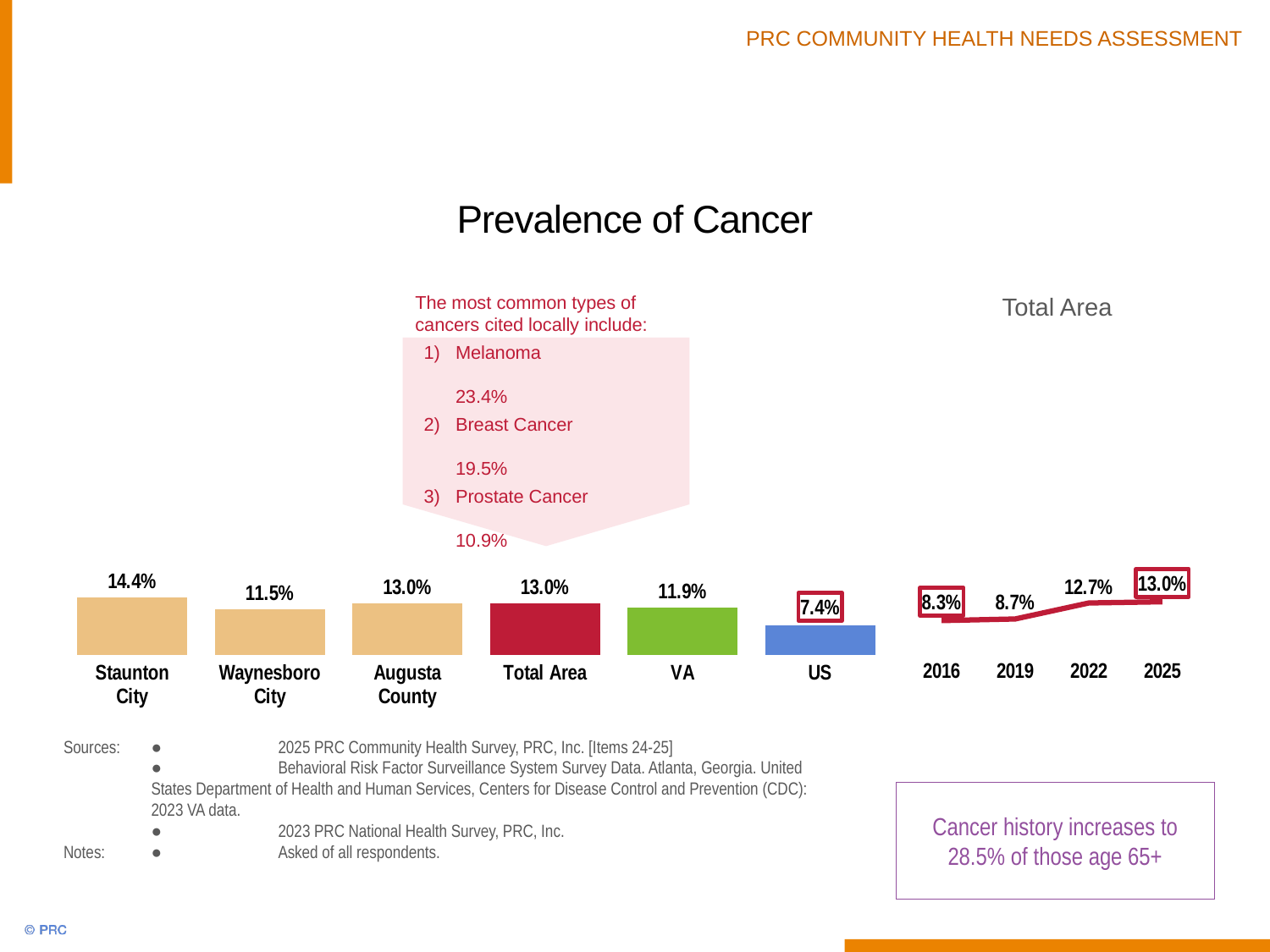
In the bar chart on the left, what is the value for Staunton City? 14.4% In the bar chart on the left, which category has the lowest value? US In the bar chart on the left, which is larger, the value for VA or the value for the US? VA In the bar chart on the left, what is the value for the US? 7.4% How many data points are shown in the Total Area line chart on the right? 4 How many categories are shown in the bar chart on the left? 6 In the Total Area line chart on the right, what is the value for 2019? 8.7% In the bar chart on the left, what is the difference between the values for Staunton City and Waynesboro City? 2.9% In the bar chart on the left, which category has the highest value? Staunton City In the Total Area line chart on the right, what is the difference between the 2025 and 2016 values? 4.7% In the Total Area line chart on the right, do the values rise or fall from 2016 to 2025? Rise What kind of chart is the chart on the left? Bar chart